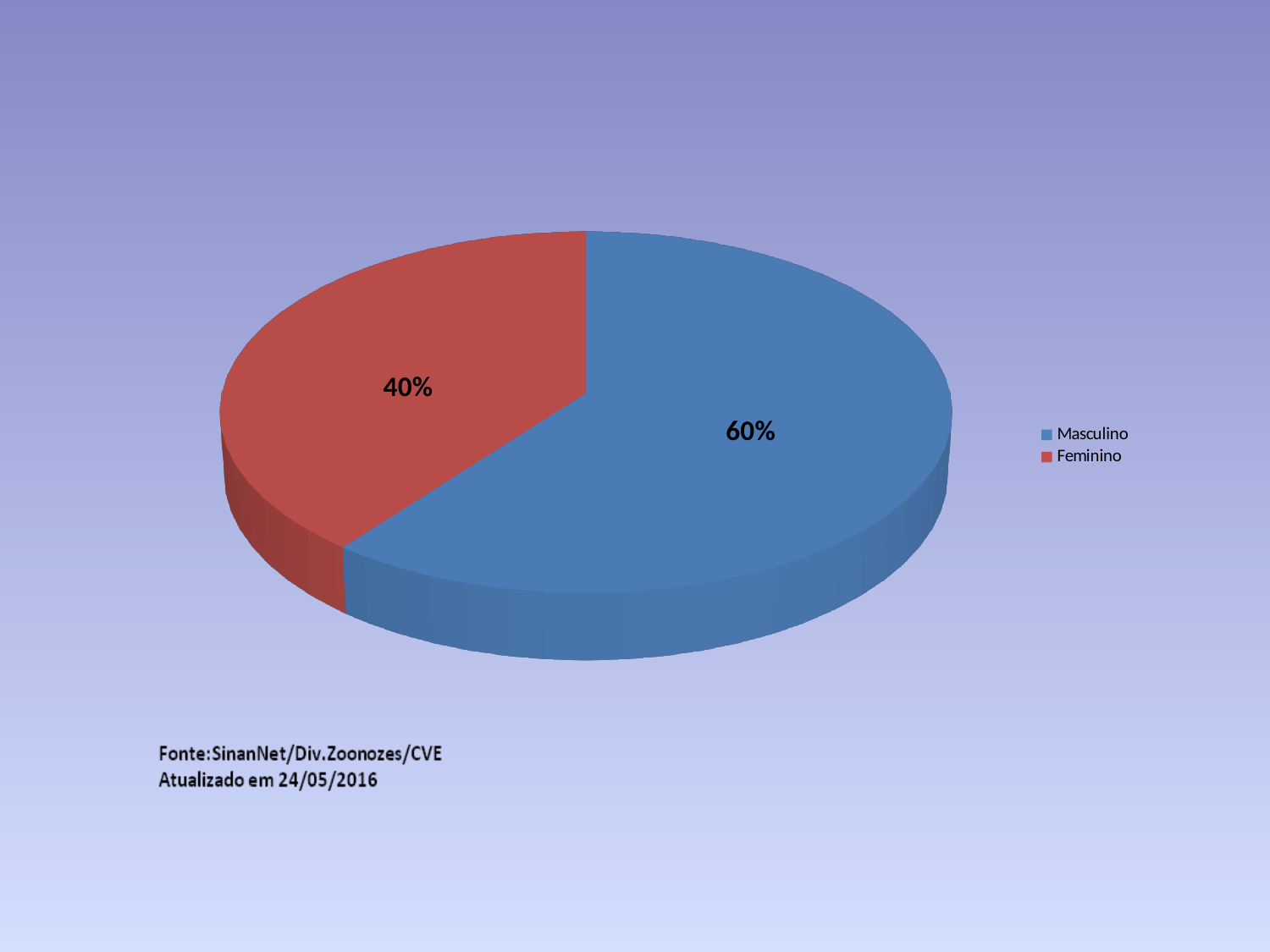
What share of the pie does the Masculino slice represent? 60% Which category has the smallest share of the pie? Feminino What colour is the Masculino slice? blue What is the difference in percentage points between the Masculino and Feminino slices? 20% Which category has the largest share of the pie? Masculino Which slice is larger, Masculino or Feminino? Masculino How many entries does the legend list? 2 What percentage of the pie is Masculino? 60% How many slices does the pie chart have? 2 What percentage of the pie is Feminino? 40% What kind of chart is shown on the slide? pie chart What colour is the Feminino slice? red